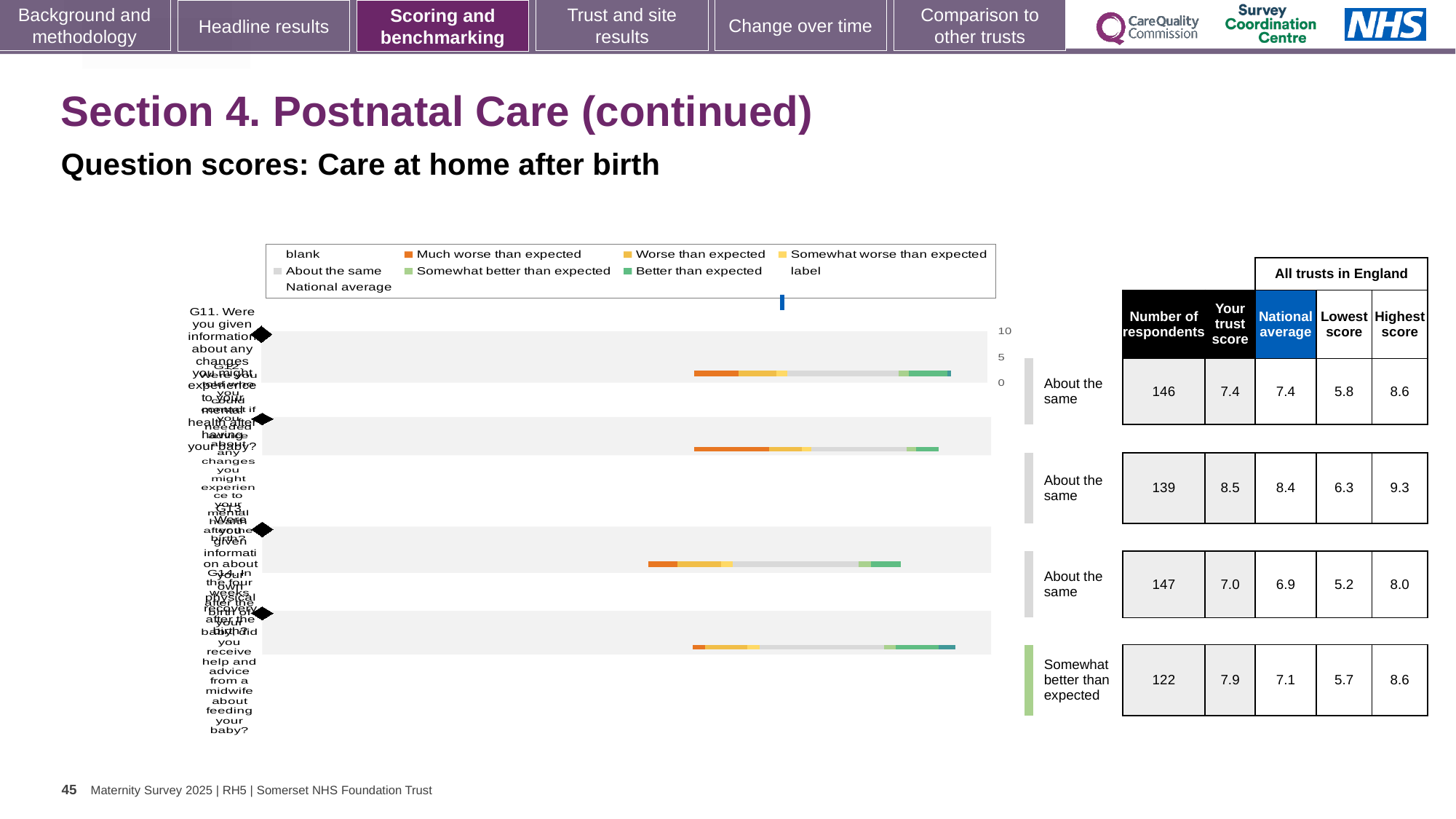
What kind of chart is shown on the slide? bar chart In the table beside the chart, what is the trust score for the second row? 8.5 Which legend entry is shown in orange in the chart? Much worse than expected In the table beside the chart, which row has the lowest number of respondents? the fourth row (122) In the table beside the chart, what is the highest score for the fourth (bottom) row? 8.6 What is the highest tick value shown on the chart's axis? 10 In the table beside the chart, what is the number of respondents for the first (top) row? 146 In the table beside the chart, what is the difference between the trust score and the national average in the fourth row? 0.8 Which benchmark label is shown for the fourth (bottom) bar of the chart? Somewhat better than expected How many horizontal bars are plotted in the chart? 4 In the table beside the chart, what is the national average for the third row? 6.9 In the table beside the chart, which row has the highest trust score? the second row (8.5)